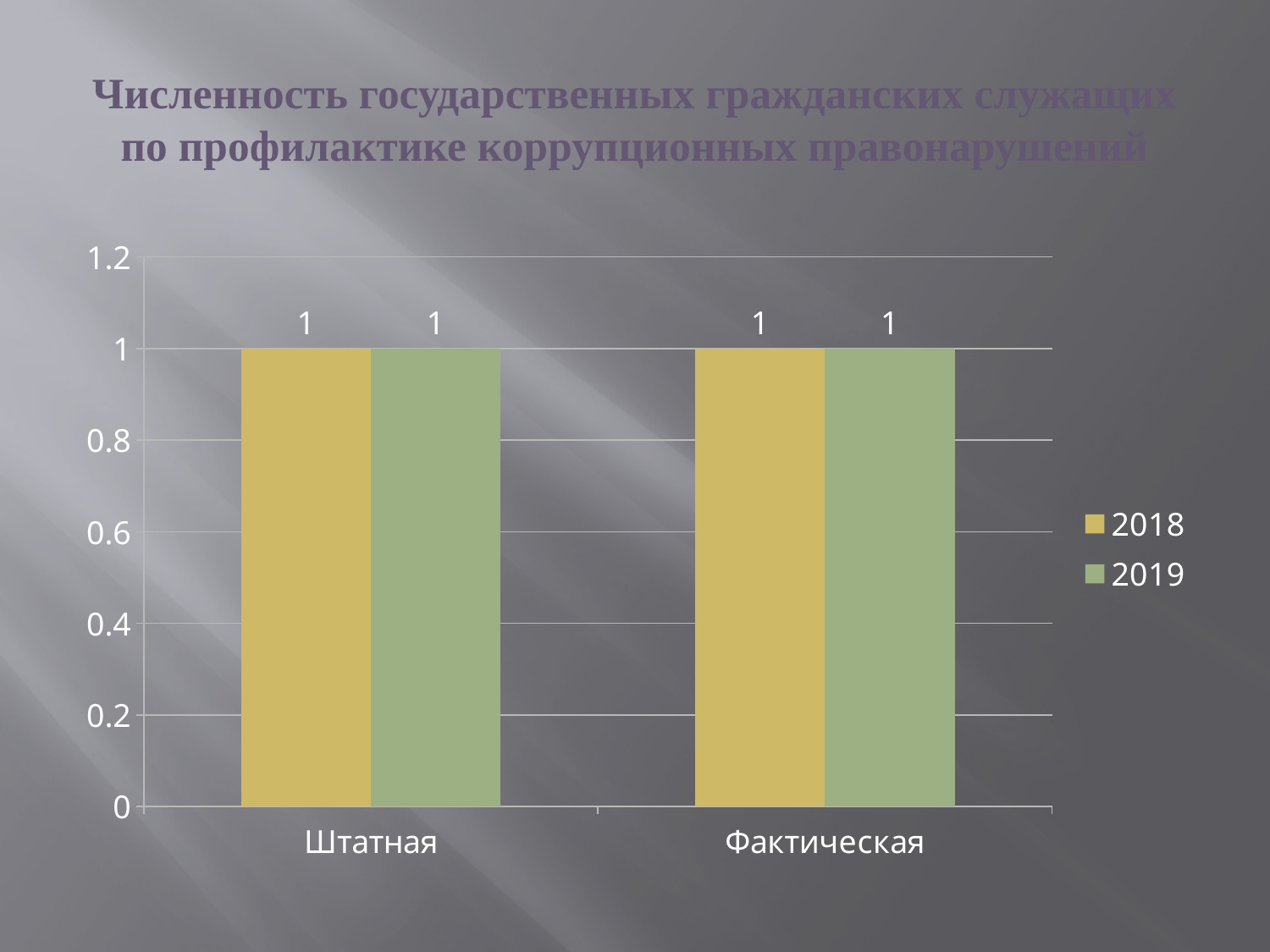
Which series are listed in the legend? 2018 and 2019 What is the value for Фактическая in 2019? 1 What is the value for Штатная in 2018? 1 How many series does the legend list? 2 What is the title of the chart? Численность государственных гражданских служащих по профилактике коррупционных правонарушений How many categories are shown on the x axis? 2 What is the value for Штатная in 2019? 1 What is the difference between the 2018 and 2019 values for Штатная? 0 Is the value for Штатная in 2018 greater or less than 0.8? greater What is the value for Фактическая in 2018? 1 What kind of chart is shown on the slide? bar chart What is the difference between the 2018 values for Штатная and Фактическая? 0